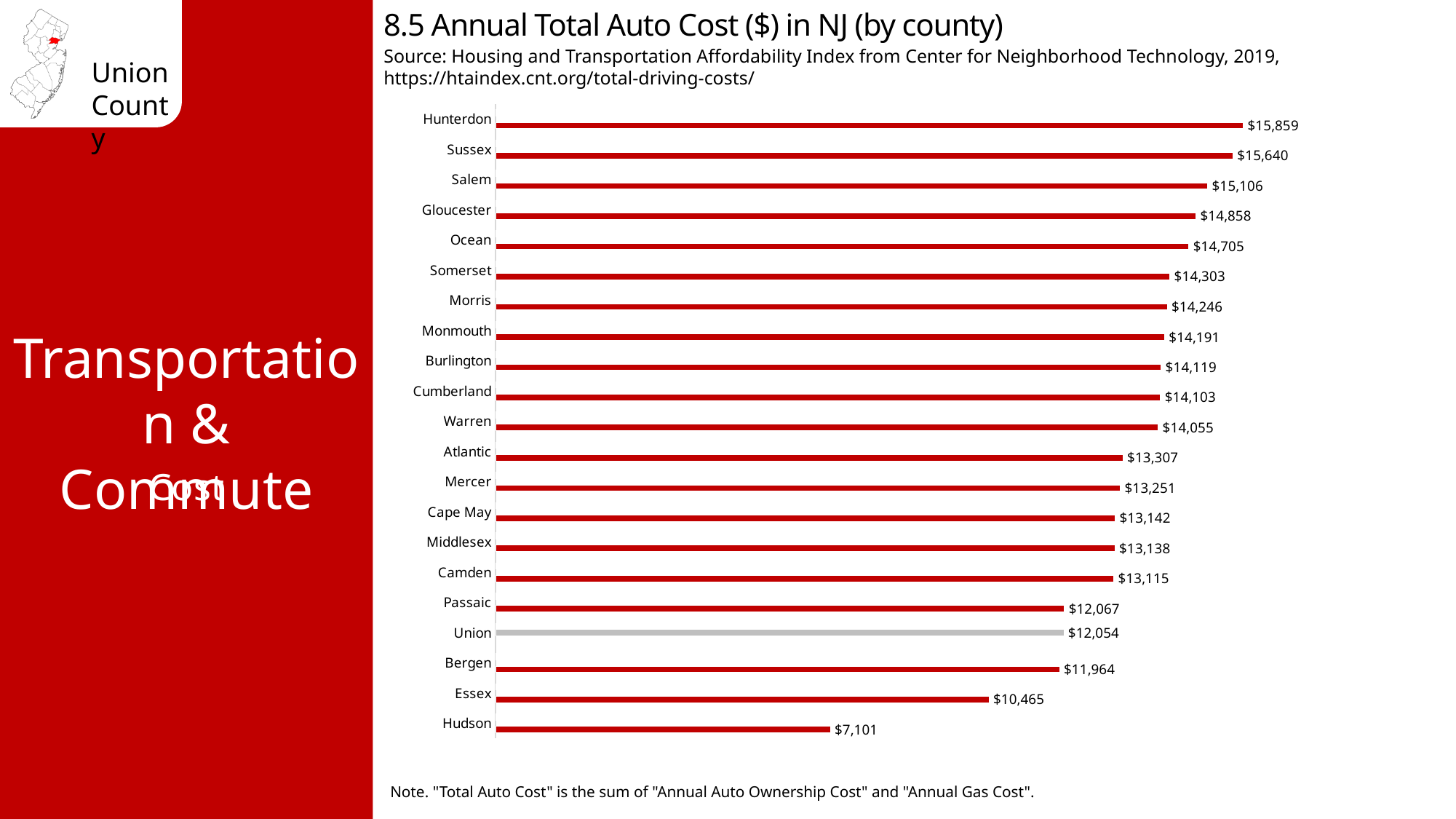
Which county's bar is shown in a different colour (grey) from the others? Union Which county has the lowest annual total auto cost? Hudson What is the difference in annual total auto cost between Hunterdon and Hudson? $8,758 What is the annual total auto cost for Hunterdon county? $15,859 Which county has a higher annual total auto cost, Bergen or Essex? Bergen What is the annual total auto cost for Essex county? $10,465 What type of chart is used to show annual total auto cost by county? Bar chart Which county has a higher annual total auto cost, Sussex or Salem? Sussex Which county has the highest annual total auto cost? Hunterdon What is the annual total auto cost for Union county? $12,054 What is the difference in annual total auto cost between Passaic and Union? $13 How many counties are shown in the chart? 21